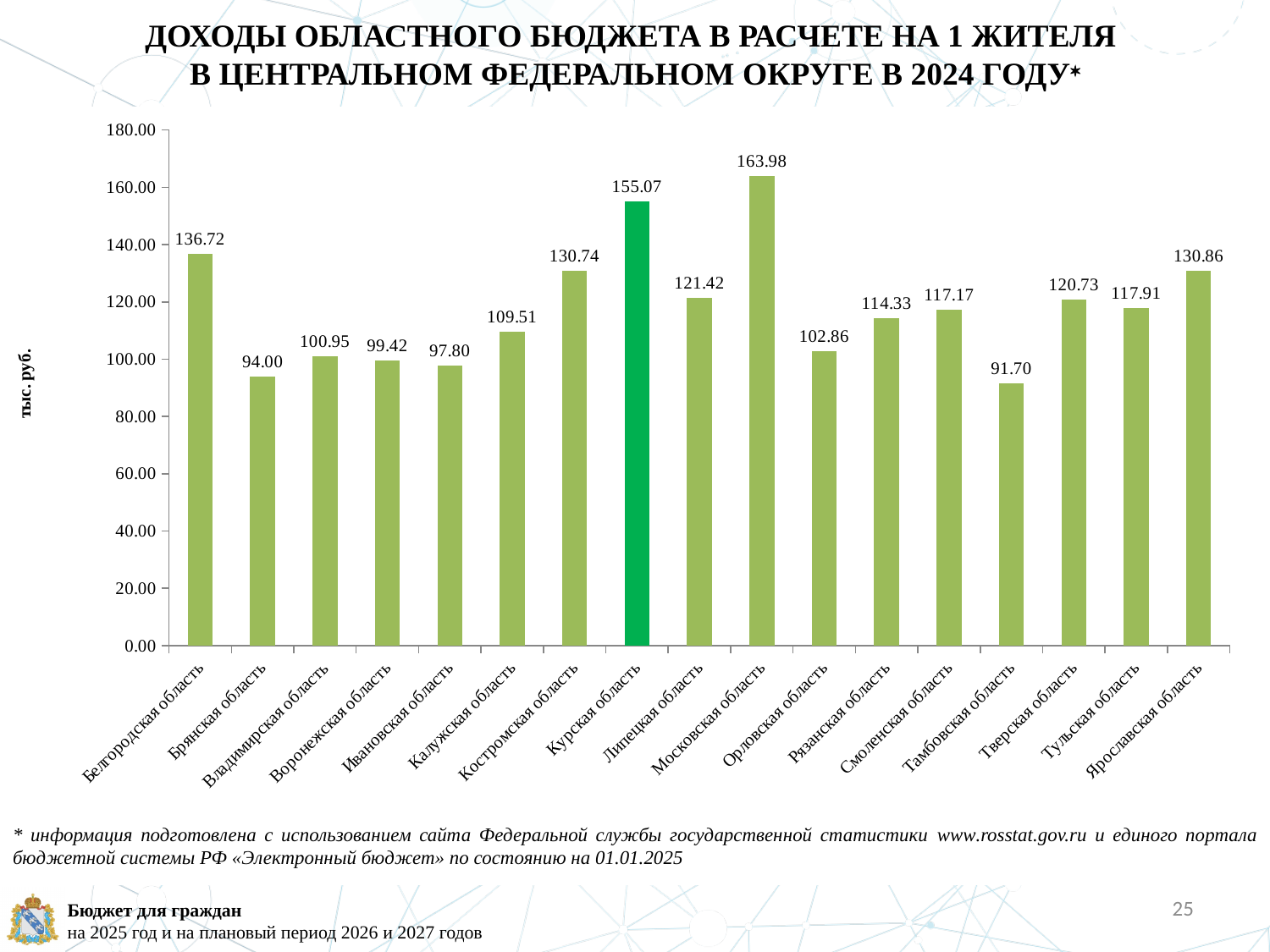
Which is larger, the value for Рязанская область or Калужская область? Рязанская область How many regions are shown on the chart? 17 Is the value for Тамбовская область greater or less than 100.00? less Which region has the lowest value? Тамбовская область What is the difference between the values for Белгородская область and Брянская область? 42.72 What is the difference between the values for Московская область and Курская область? 8.91 What is the value for Курская область? 155.07 Which region has the highest value? Московская область Which region's bar is highlighted in a different (bright green) colour? Курская область What kind of chart is shown on the slide? bar chart What is the value for Тульская область? 117.91 What is the value for Белгородская область? 136.72